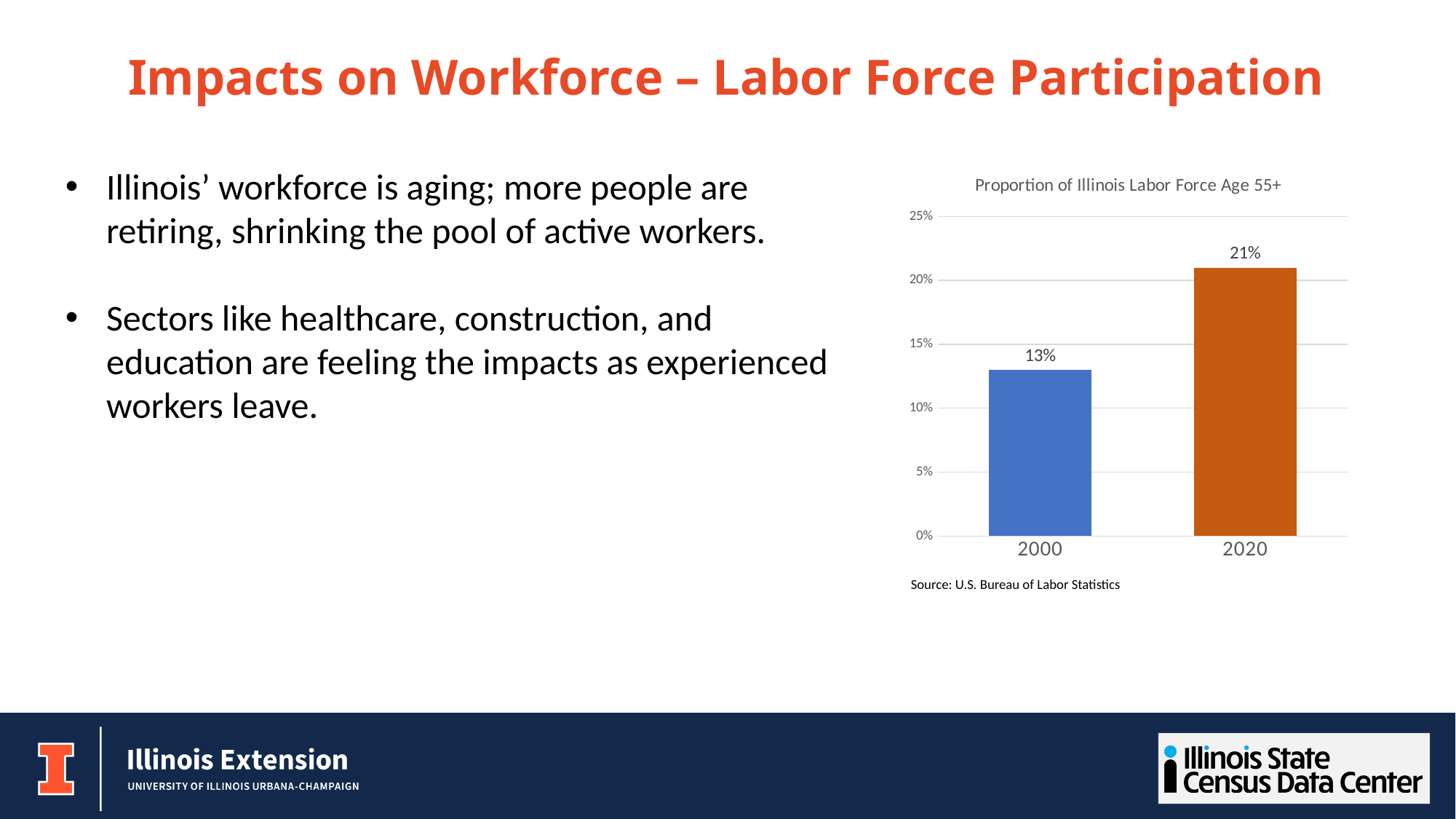
What is the value for 2020? 21% What is the value for 2000? 13% Is the value for 2020 greater or less than 20%? greater Do the values rise or fall from 2000 to 2020? rise Is the value for 2000 greater or less than 15%? less Which year has the lowest proportion of the labor force age 55+? 2000 Which year has the highest proportion of the labor force age 55+? 2020 What is the title of the chart? Proportion of Illinois Labor Force Age 55+ What kind of chart is shown on the slide? bar chart What is the difference between the values for 2020 and 2000? 8% Which is larger, the value for 2000 or the value for 2020? 2020 How many years are shown on the chart? 2